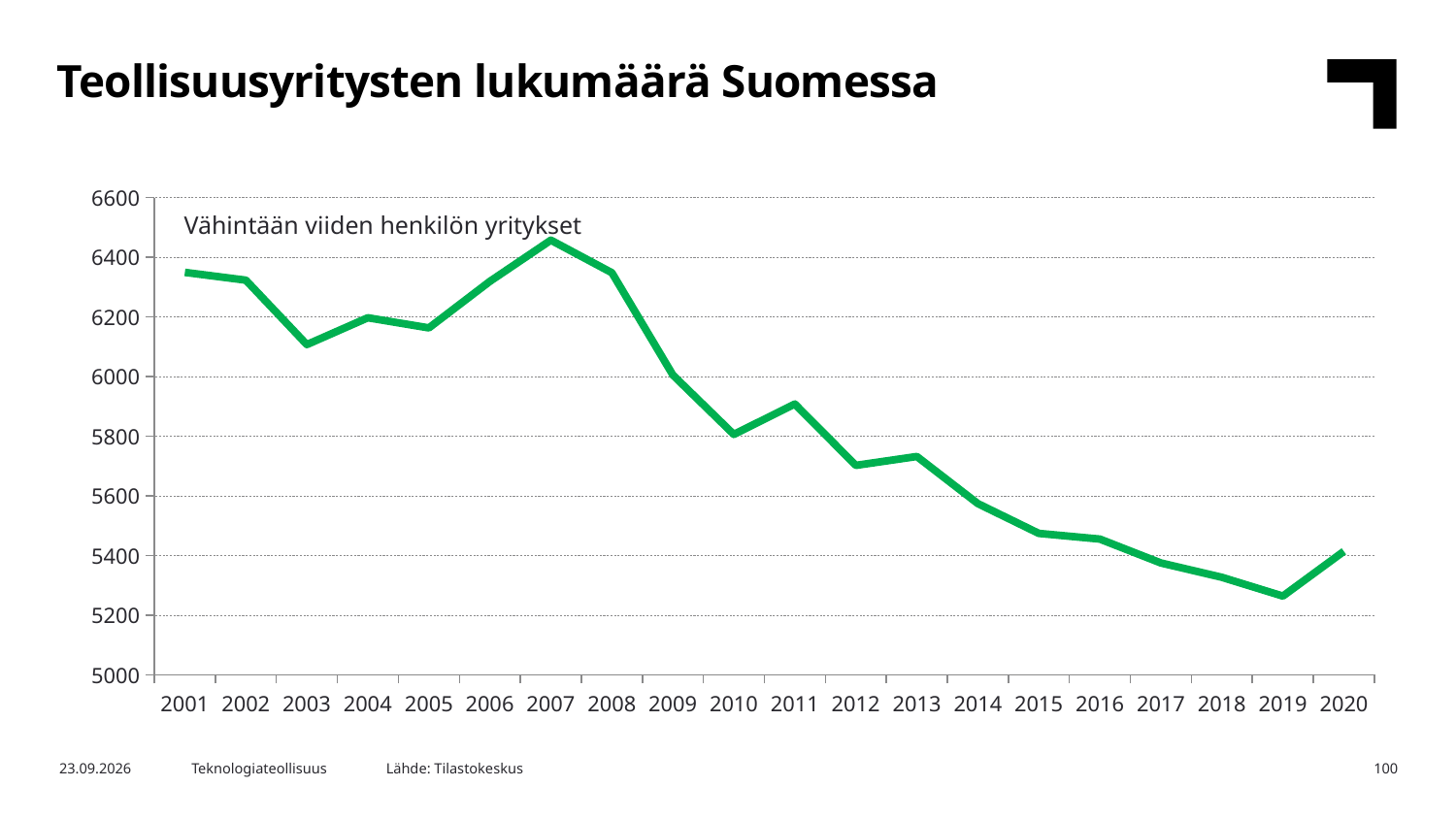
What is the title of the chart? Teollisuusyritysten lukumäärä Suomessa Overall, do the values rise or fall from 2001 to 2020? fall In which year is the number of industrial companies lowest? 2019 Is the value for 2003 greater or less than 6000? greater Is the value for 2019 greater or less than 5200? greater Is the value for 2012 greater or less than 5800? less What kind of chart is shown on the slide? line chart How many years are plotted on the x axis? 20 In which year is the number of industrial companies highest? 2007 Which year has the larger value, 2010 or 2011? 2011 Which year has the larger value, 2001 or 2020? 2001